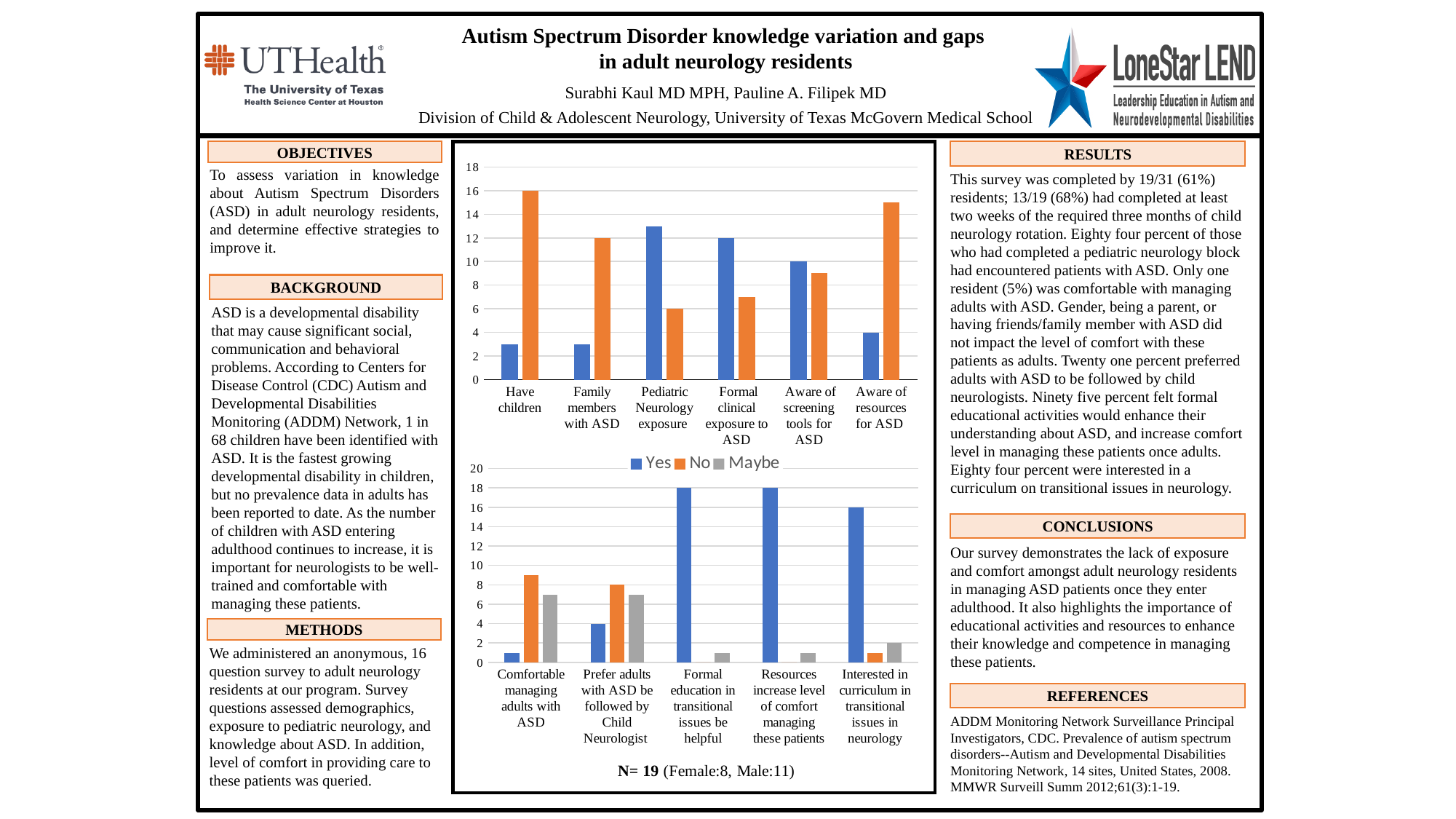
How many categories are shown on the x axis of the bottom chart? 5 In the top chart, what is the value of the orange bar for "Have children"? 16 In the bottom chart, what is the No value for "Prefer adults with ASD be followed by Child Neurologist"? 8 In the bottom chart, for "Comfortable managing adults with ASD", which is larger: the Yes value or the No value? No In the bottom chart, what is the Yes value for "Formal education in transitional issues be helpful"? 18 How many categories are shown on the x axis of the top chart? 6 What are the legend entries of the bottom chart? Yes, No, Maybe In the bottom chart, which category has the lowest Yes value? Comfortable managing adults with ASD How many series does the legend of the bottom chart list? 3 In the bottom chart, what is the Yes value for "Interested in curriculum in transitional issues in neurology"? 16 In the top chart, is the value of the blue bar for "Pediatric Neurology exposure" greater or less than 10? greater What kind of chart is the bottom chart on the slide? bar chart